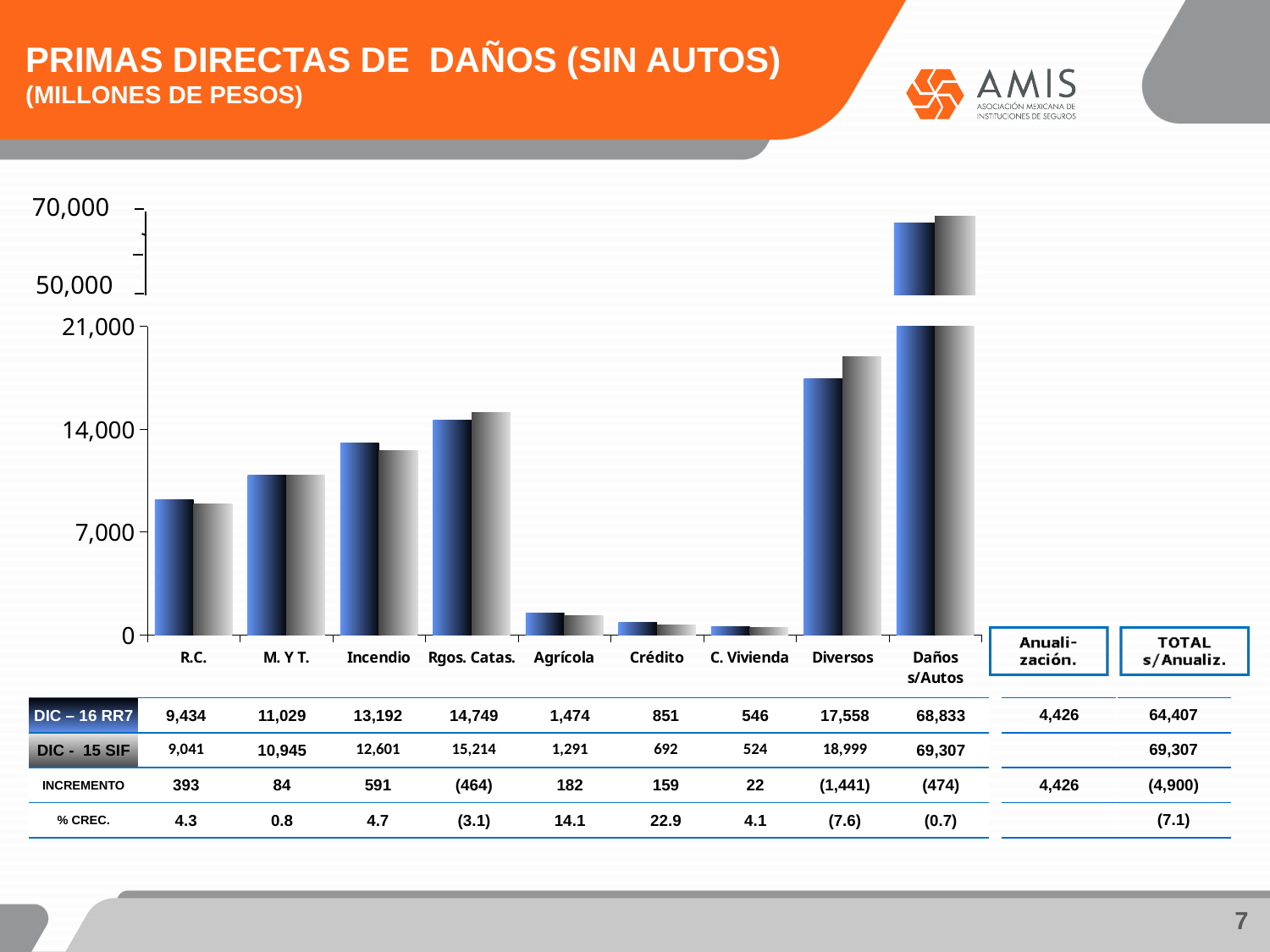
What is the DIC – 16 RR7 value for Incendio? 13,192 What is the difference between the DIC – 16 RR7 and DIC - 15 SIF values for Incendio? 591 How many categories are shown on the x axis of the chart? 9 What is the DIC - 15 SIF value for Diversos? 18,999 What is the DIC – 16 RR7 value for Agrícola? 1,474 For Diversos, which is larger: the DIC – 16 RR7 value or the DIC - 15 SIF value? DIC - 15 SIF What is the title of the chart on the slide? PRIMAS DIRECTAS DE DAÑOS (SIN AUTOS) Which category has the highest DIC – 16 RR7 value? Daños s/Autos Is the DIC – 16 RR7 value for R.C. greater or less than 7,000? greater What kind of chart is shown on the slide? bar chart Which category has the lowest DIC – 16 RR7 value? C. Vivienda What is the % CREC. value for Crédito? 22.9